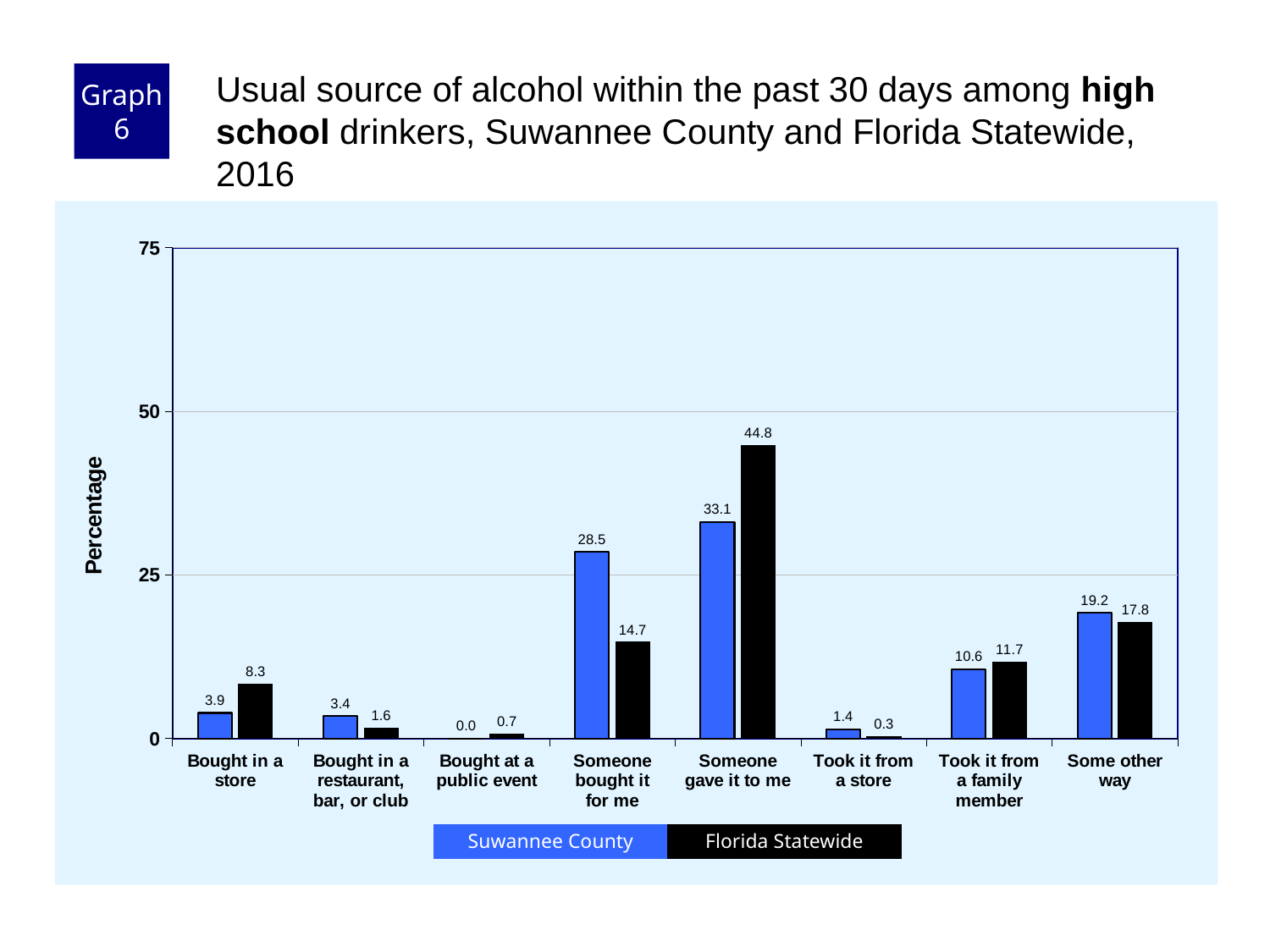
Which category has the lowest Suwannee County value? Bought at a public event What is the difference between the Suwannee County and Florida Statewide values for "Someone bought it for me"? 13.8 Is the Suwannee County value for "Someone gave it to me" greater or less than 25? greater How many categories are shown on the x axis? 8 How many series does the legend list? 2 What type of chart is shown on the slide? Bar chart What is the Florida Statewide value for "Someone gave it to me"? 44.8 What is the Florida Statewide value for "Bought at a public event"? 0.7 What is the difference between the Florida Statewide and Suwannee County values for "Someone gave it to me"? 11.7 What is the Suwannee County value for "Someone bought it for me"? 28.5 Which category has the highest Florida Statewide value? Someone gave it to me Which is larger for "Bought in a store": Suwannee County or Florida Statewide? Florida Statewide